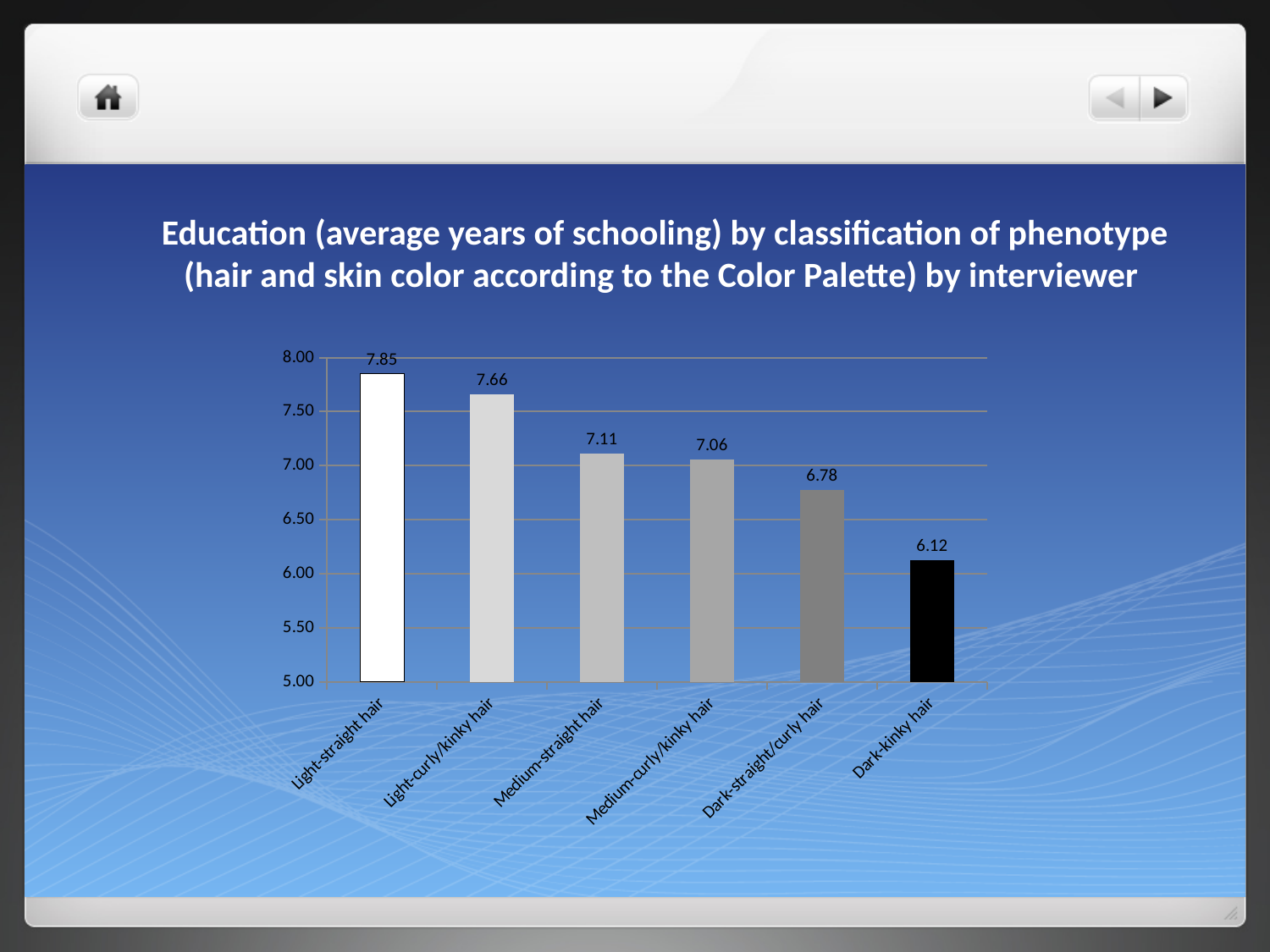
How many phenotype categories are shown on the chart? 6 What kind of chart is shown on the slide? Bar chart What is the value shown for Dark-kinky hair? 6.12 Do the values rise or fall moving from left to right along the x axis? Fall What is the value shown for Medium-curly/kinky hair? 7.06 Which phenotype category has the highest average years of schooling? Light-straight hair Is the value for Dark-straight/curly hair greater or less than 7.00? less What is the difference between the values for Light-straight hair and Dark-kinky hair? 1.73 What is the difference between the values for Light-curly/kinky hair and Dark-straight/curly hair? 0.88 Which is larger, the value for Medium-straight hair or the value for Dark-straight/curly hair? Medium-straight hair What is the average years of schooling for Light-straight hair? 7.85 Which phenotype category has the lowest average years of schooling? Dark-kinky hair